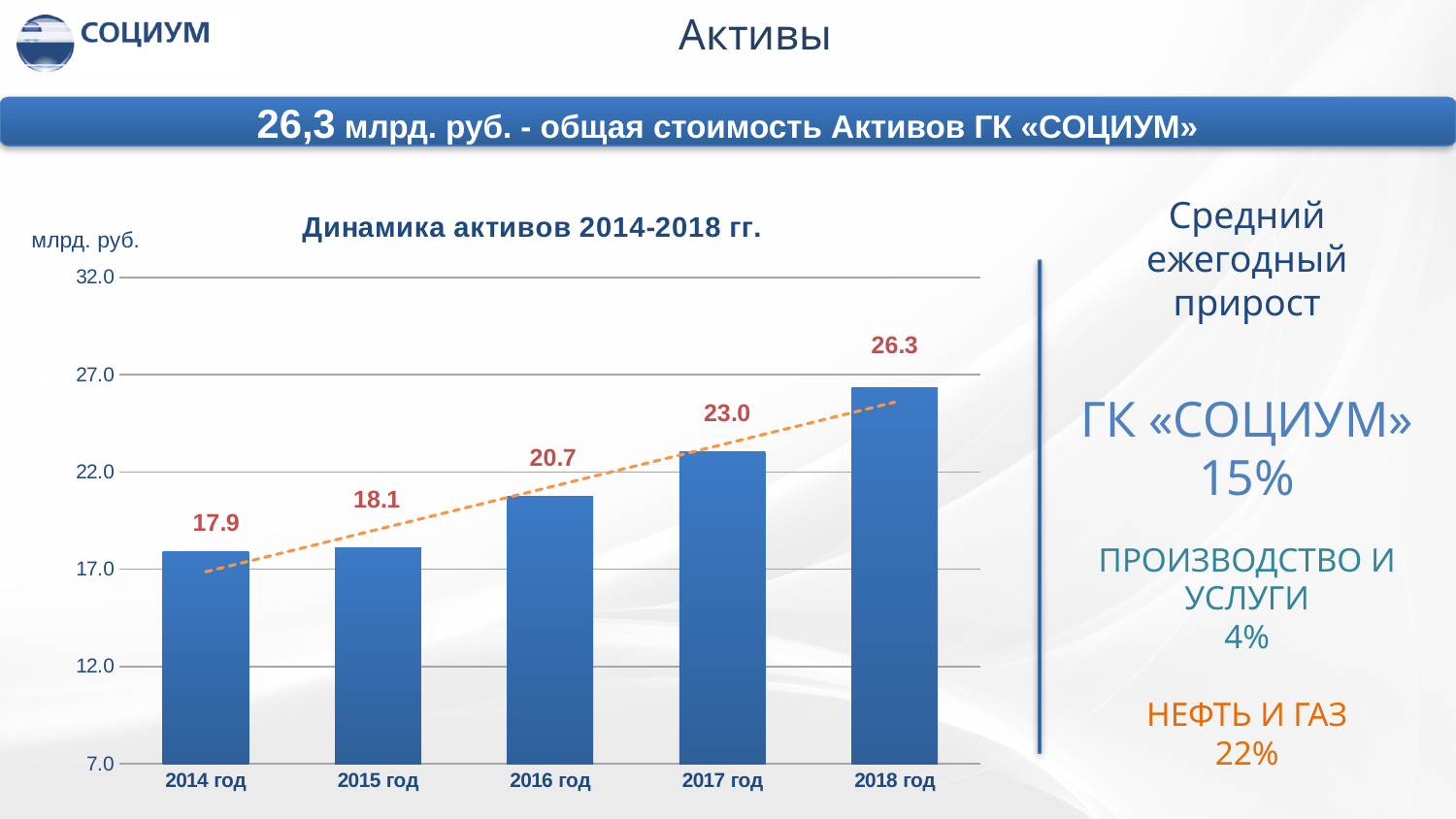
Do the values rise or fall from 2014 год to 2018 год? rise What is the difference between the values for 2018 год and 2017 год? 3.3 How many years are shown on the x axis of the chart? 5 Which is larger, the value for 2017 год or the value for 2015 год? 2017 год What is the difference between the values for 2016 год and 2015 год? 2.6 What is the value for 2018 год in the chart? 26.3 What is the title of the chart? Динамика активов 2014-2018 гг. What kind of chart is shown on the slide? bar chart Which year has the highest value in the chart? 2018 год What is the value for 2014 год in the chart? 17.9 What is the value for 2016 год in the chart? 20.7 Which year has the lowest value in the chart? 2014 год